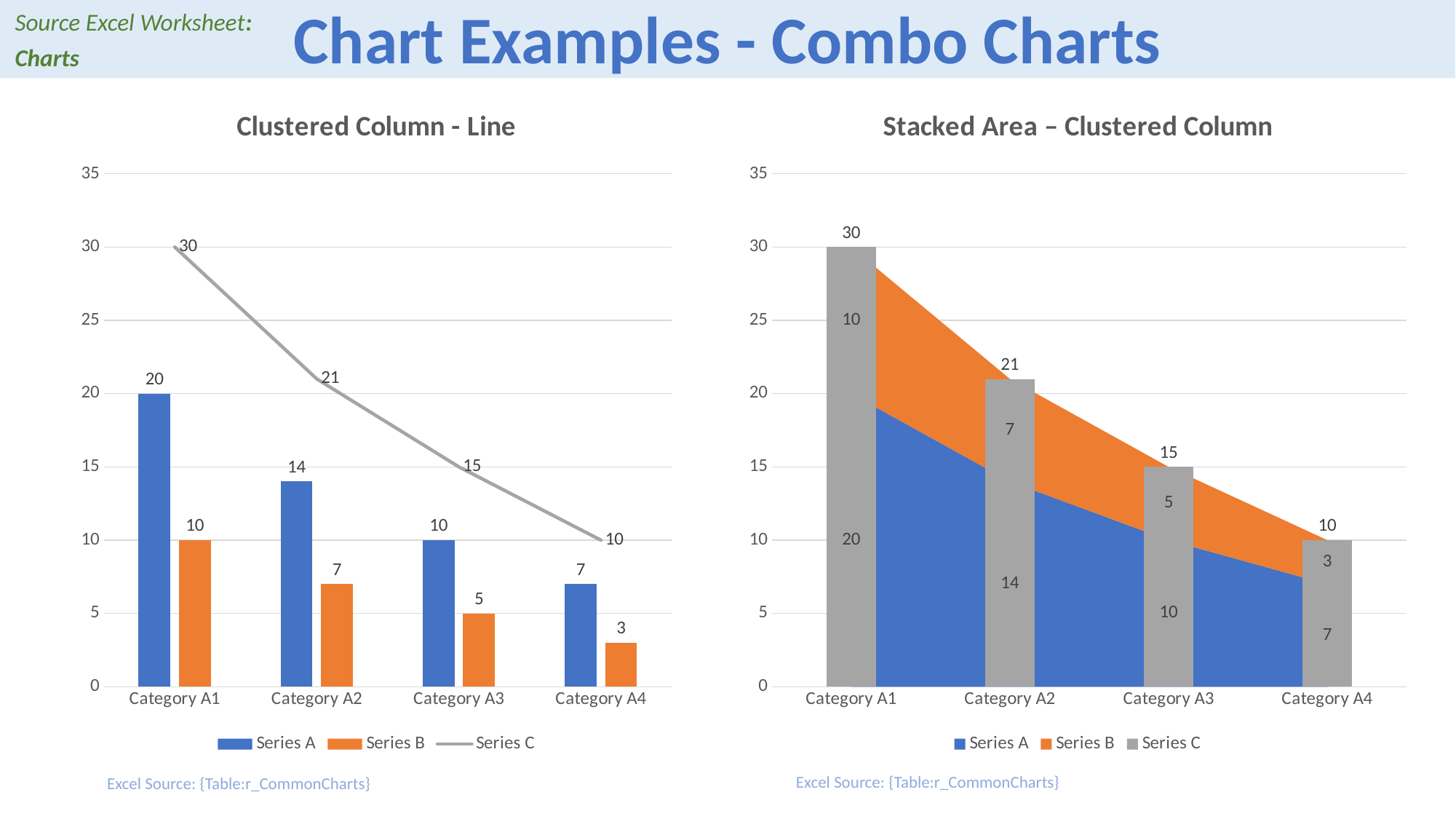
In the Stacked Area – Clustered Column chart, what is the total of Series A and Series B for Category A2? 21 In the Clustered Column - Line chart, which category has the highest Series A value? Category A1 In the Clustered Column - Line chart, what is the value of Series C for Category A2? 21 In the Clustered Column - Line chart, which category has the lowest Series B value? Category A4 In the Clustered Column - Line chart, what is the value of Series A for Category A1? 20 How many categories are shown on the x axis of the Stacked Area – Clustered Column chart? 4 How many series does the legend of the Stacked Area – Clustered Column chart list? 3 In the Stacked Area – Clustered Column chart, what is the value of Series C for Category A3? 15 In the Stacked Area – Clustered Column chart, which is larger for Category A1: Series A or Series B? Series A In the Clustered Column - Line chart, does Series C rise or fall from Category A1 to Category A4? fall In the Clustered Column - Line chart, what is the difference between Series A and Series B for Category A2? 7 In the Clustered Column - Line chart, what is the value of Series B for Category A4? 3